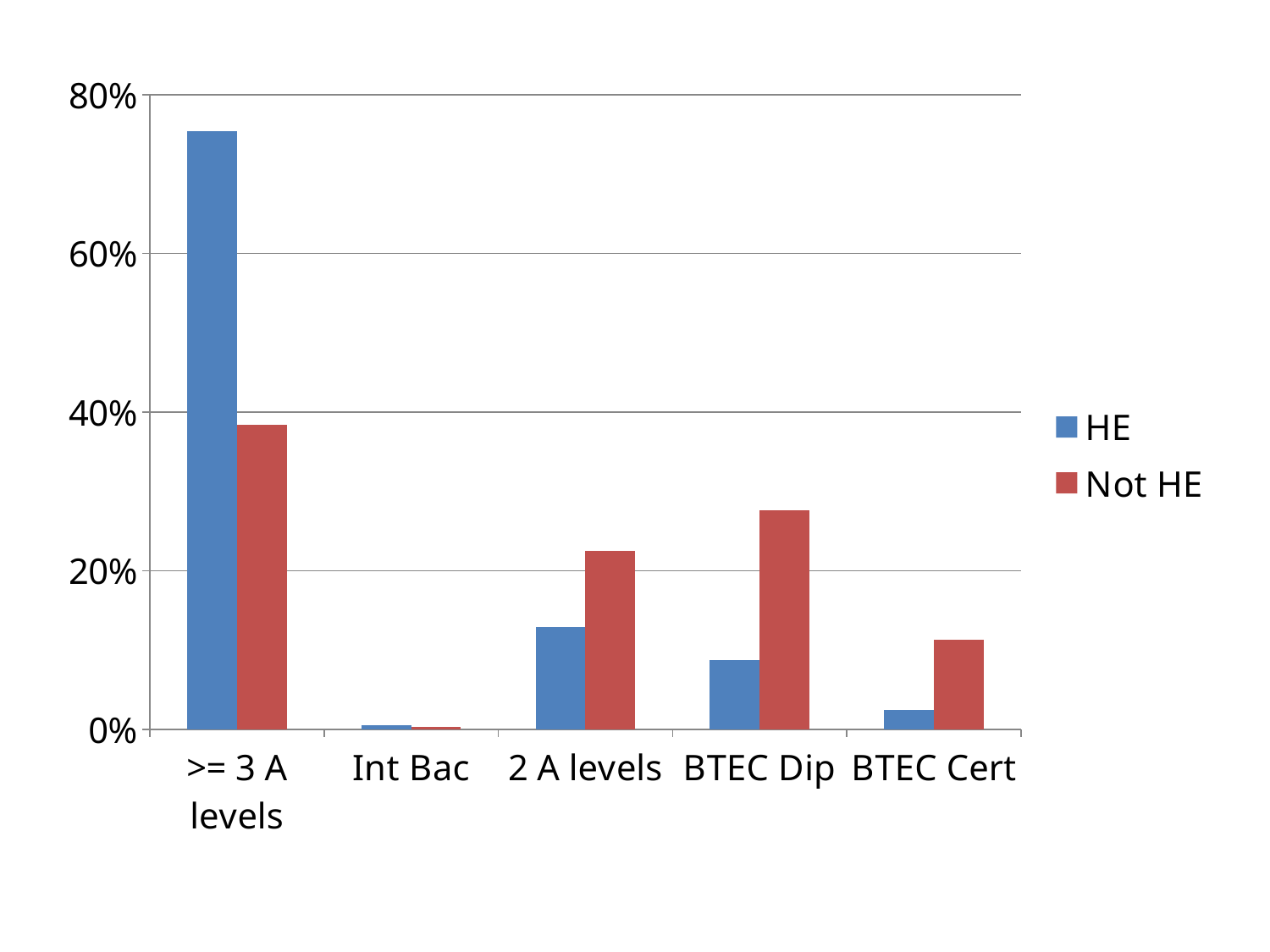
Is the HE value for BTEC Cert greater or less than 20%? less Is the Not HE value for BTEC Dip greater or less than 20%? greater For 2 A levels, which is larger: the HE value or the Not HE value? Not HE Which category has the lowest Not HE value? Int Bac Which category has the highest Not HE value? >= 3 A levels How many series does the legend list? 2 What colour are the Not HE bars? red How many categories are shown on the x axis? 5 Which category has the highest HE value? >= 3 A levels Is the HE value for >= 3 A levels greater or less than 60%? greater What kind of chart is shown on the slide? bar chart For >= 3 A levels, which is larger: the HE value or the Not HE value? HE